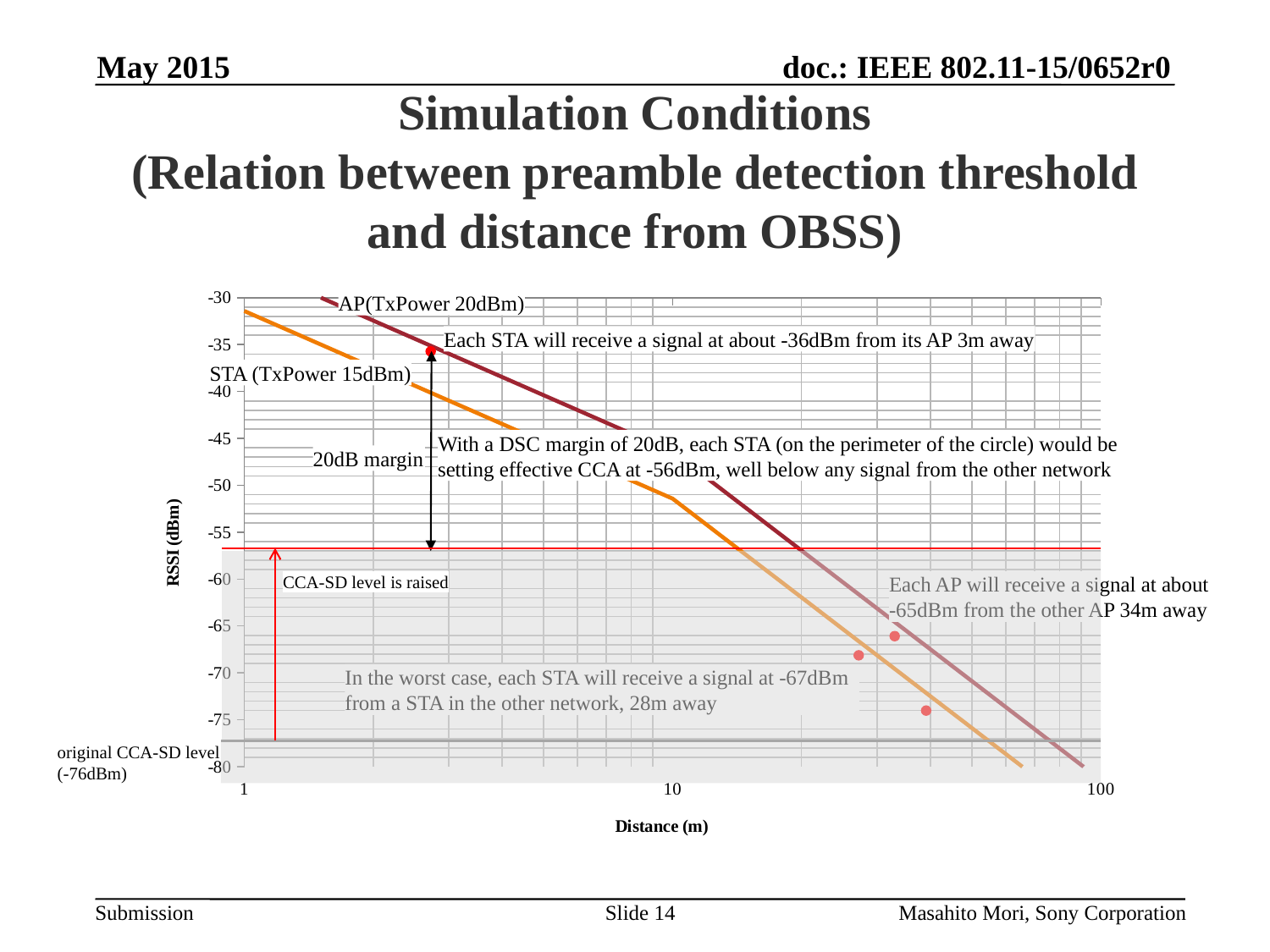
What kind of chart is shown on the slide? line chart According to the annotation, at what signal level will each STA receive a signal from its AP 3m away? -36dBm In the worst case, at what signal level will each STA receive a signal from a STA in the other network, and how far away is that STA? -67dBm, 28m away What is the label of the x axis of the chart? Distance (m) At a distance of 10m, which series has the higher RSSI, AP (TxPower 20dBm) or STA (TxPower 15dBm)? AP (TxPower 20dBm) How many series are plotted in the chart? 2 According to the annotation, at what level would each STA set its effective CCA with a DSC margin of 20dB? -56dBm Do the RSSI values rise or fall as distance increases? fall What is the label of the y axis of the chart? RSSI (dBm) What is the original CCA-SD level shown on the chart? -76dBm According to the annotation, at what signal level will each AP receive a signal from the other AP 34m away? -65dBm Is the RSSI of the AP (TxPower 20dBm) series at 100m greater or less than -75? less